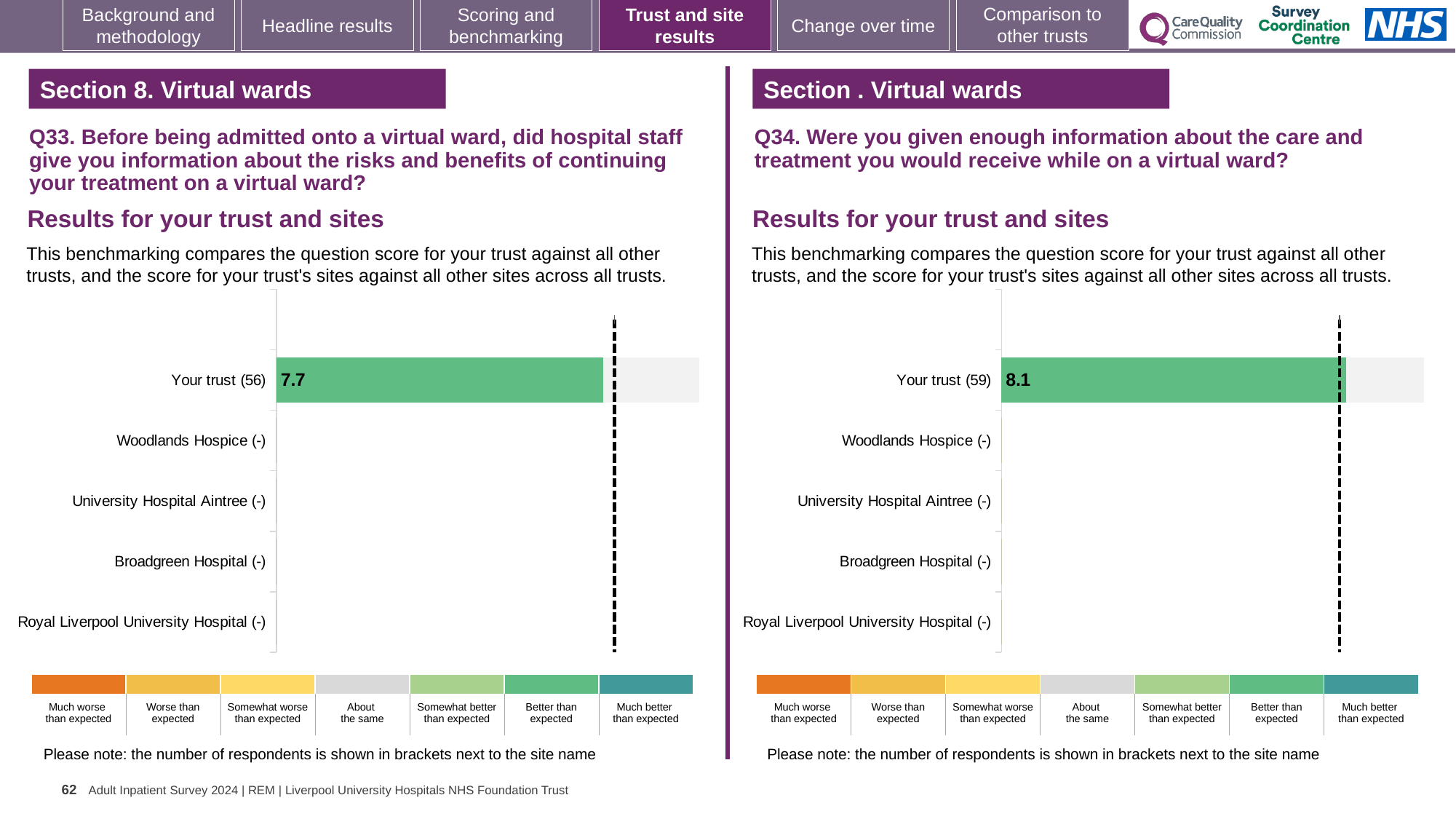
In the Q34 chart on the right, what colour is the Your trust bar? Green How many site/trust categories are listed on the y axis of the Q33 chart on the left? 5 Which is larger: the Your trust score in the Q33 chart on the left or the Your trust score in the Q34 chart on the right? Q34 (8.1) What is the difference between the Your trust score in the Q34 chart on the right and the Your trust score in the Q33 chart on the left? 0.4 What kind of chart is used for the Q33 results on the left? Bar chart In the Q33 chart on the left, which category has the highest score shown? Your trust (56) How many site/trust categories are listed on the y axis of the Q34 chart on the right? 5 How many benchmark categories does the colour key below the Q33 chart on the left list? 7 In the Q34 chart on the right, how many respondents are shown in brackets next to Your trust? 59 In the Q33 chart on the left, how many respondents are shown in brackets next to Your trust? 56 In the Q34 chart on the right, what is the score for Your trust? 8.1 In the Q33 chart on the left, what is the score for Your trust? 7.7